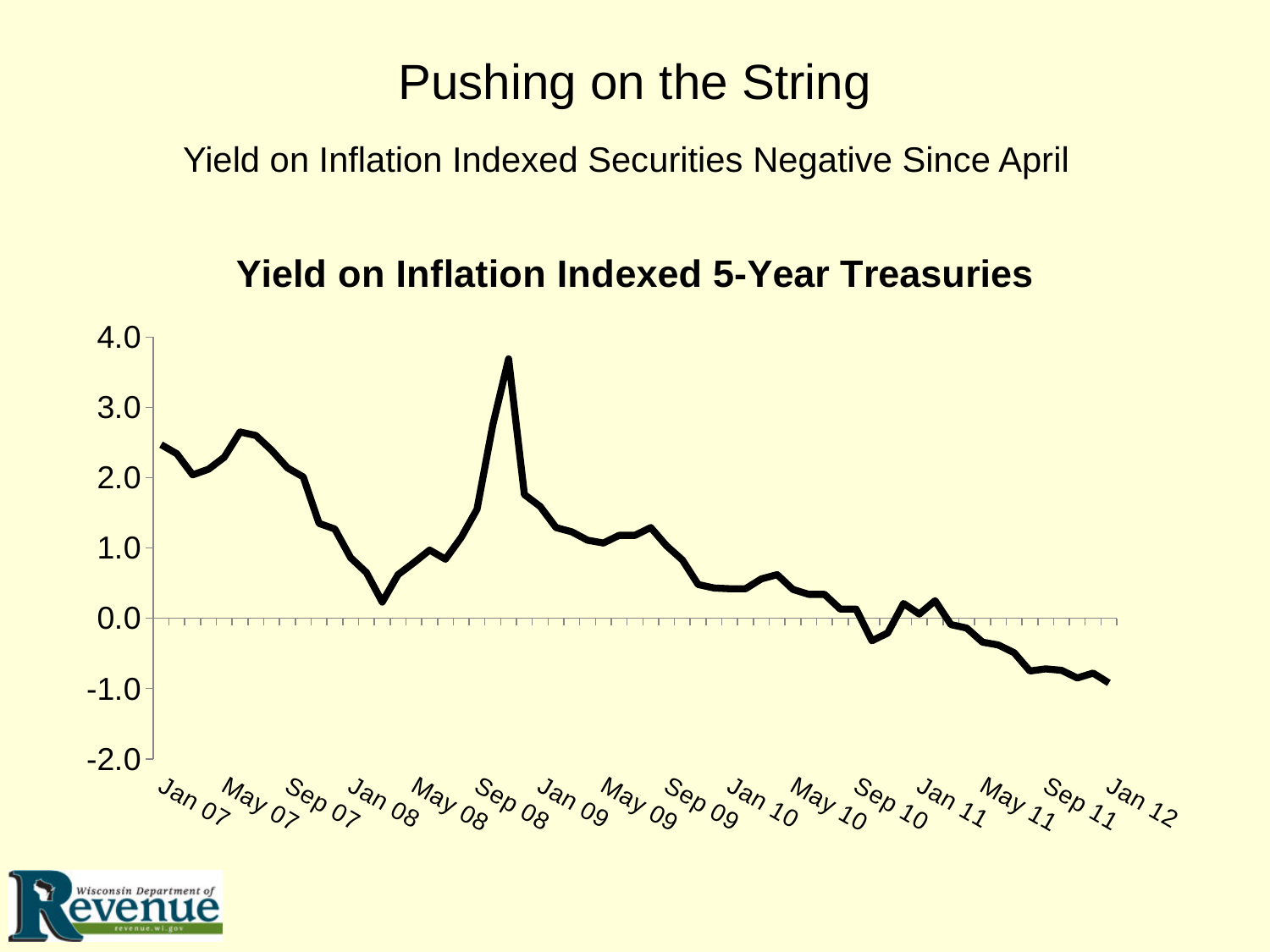
At which labelled month is the line at its lowest value? Jan 12 What is the title of the chart? Yield on Inflation Indexed 5-Year Treasuries What kind of chart is shown on the slide? line chart Is the value for Sep 08 greater or less than 3.0? less How many month labels are shown along the x axis? 16 Is the value for Jan 07 greater or less than 2.0? greater Is the value for Jan 12 greater or less than 0.0? less Which is larger, the value for Jan 07 or the value for Jan 12? Jan 07 Overall, does the yield rise or fall from Jan 07 to Jan 12? fall